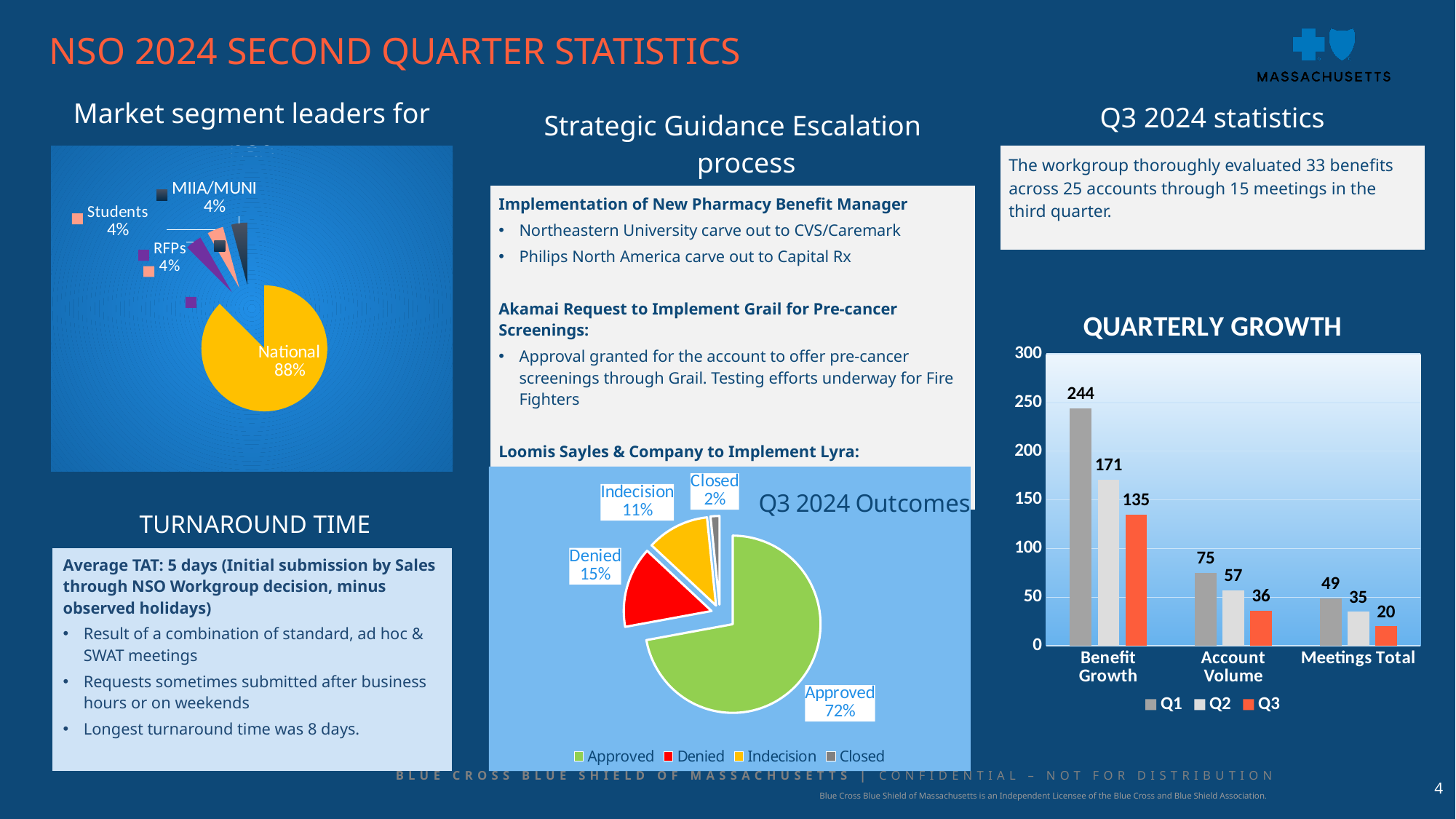
In the Market segment leaders pie chart, what share is National? 88% In the Quarterly Growth chart, what is the Q1 value for Benefit Growth? 244 In the Q3 2024 Outcomes pie chart, what share is Denied? 15% In the Quarterly Growth chart, which category has the highest Q1 value? Benefit Growth What kind of chart is the Quarterly Growth chart? bar chart How many slices does the legend of the Q3 2024 Outcomes pie chart list? 4 In the Quarterly Growth chart, what is the difference between the Q1 and Q3 values for Benefit Growth? 109 In the Quarterly Growth chart, do the values for Account Volume rise or fall from Q1 to Q3? fall In the Quarterly Growth chart, what is the Q2 value for Meetings Total? 35 In the Q3 2024 Outcomes pie chart, which slice is the smallest? Closed In the Quarterly Growth chart, what is the Q3 value for Account Volume? 36 How many series does the legend of the Quarterly Growth chart list? 3